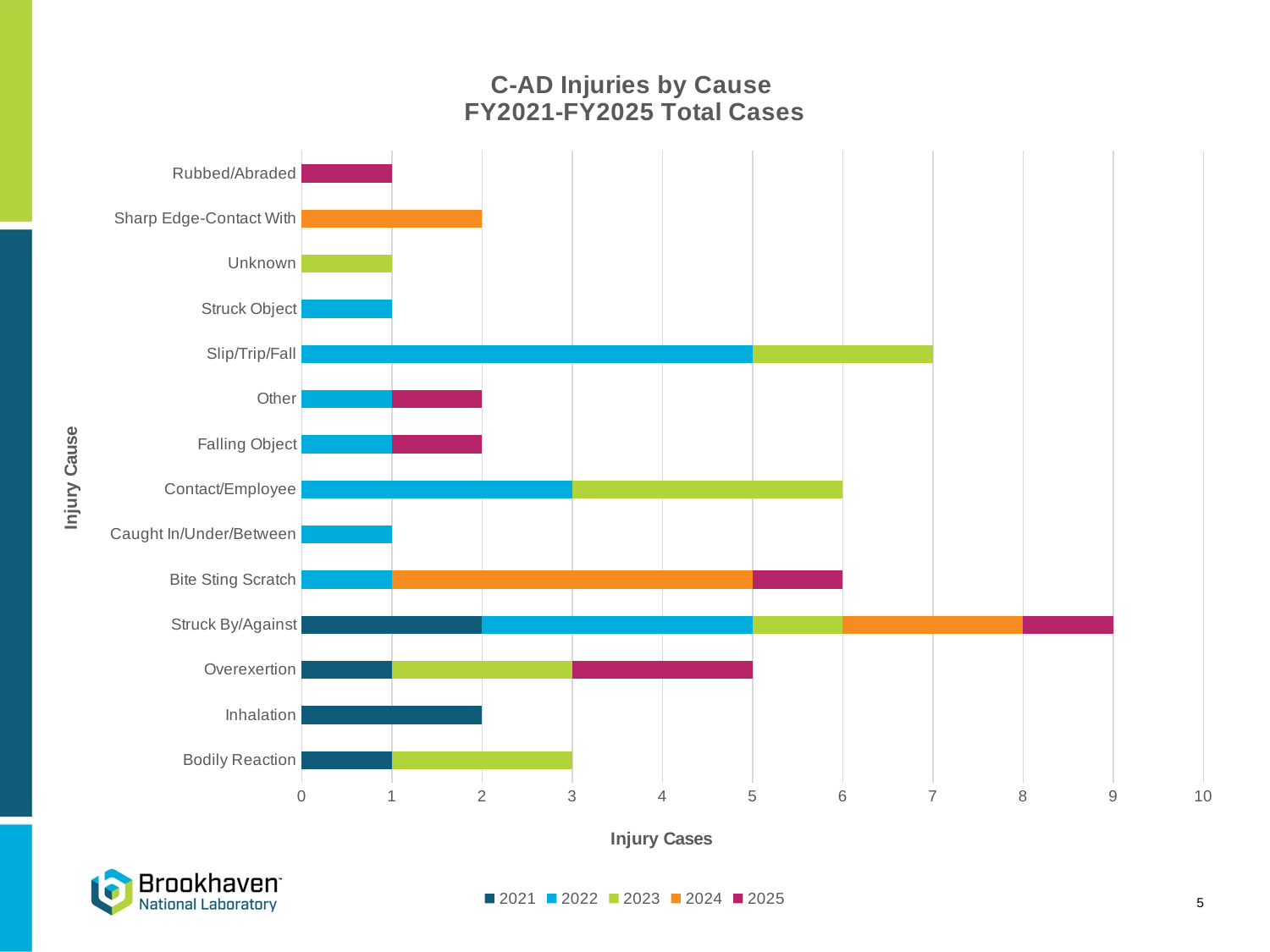
What is the title of the chart? C-AD Injuries by Cause FY2021-FY2025 Total Cases Which has more total injury cases, Contact/Employee or Bodily Reaction? Contact/Employee How many injury cause categories are shown on the chart? 14 How many series does the legend list? 5 How many Inhalation injury cases were recorded in 2021? 2 What is the difference between the total cases for Struck By/Against and the total cases for Overexertion? 4 Which injury cause has the highest total number of cases? Struck By/Against How many Slip/Trip/Fall injury cases were recorded in 2022? 5 What is the total number of injury cases for Struck By/Against? 9 What type of chart is shown on the slide? Stacked bar chart What is the total number of injury cases for Slip/Trip/Fall? 7 Is the total number of cases for Bite Sting Scratch greater or less than 5? greater